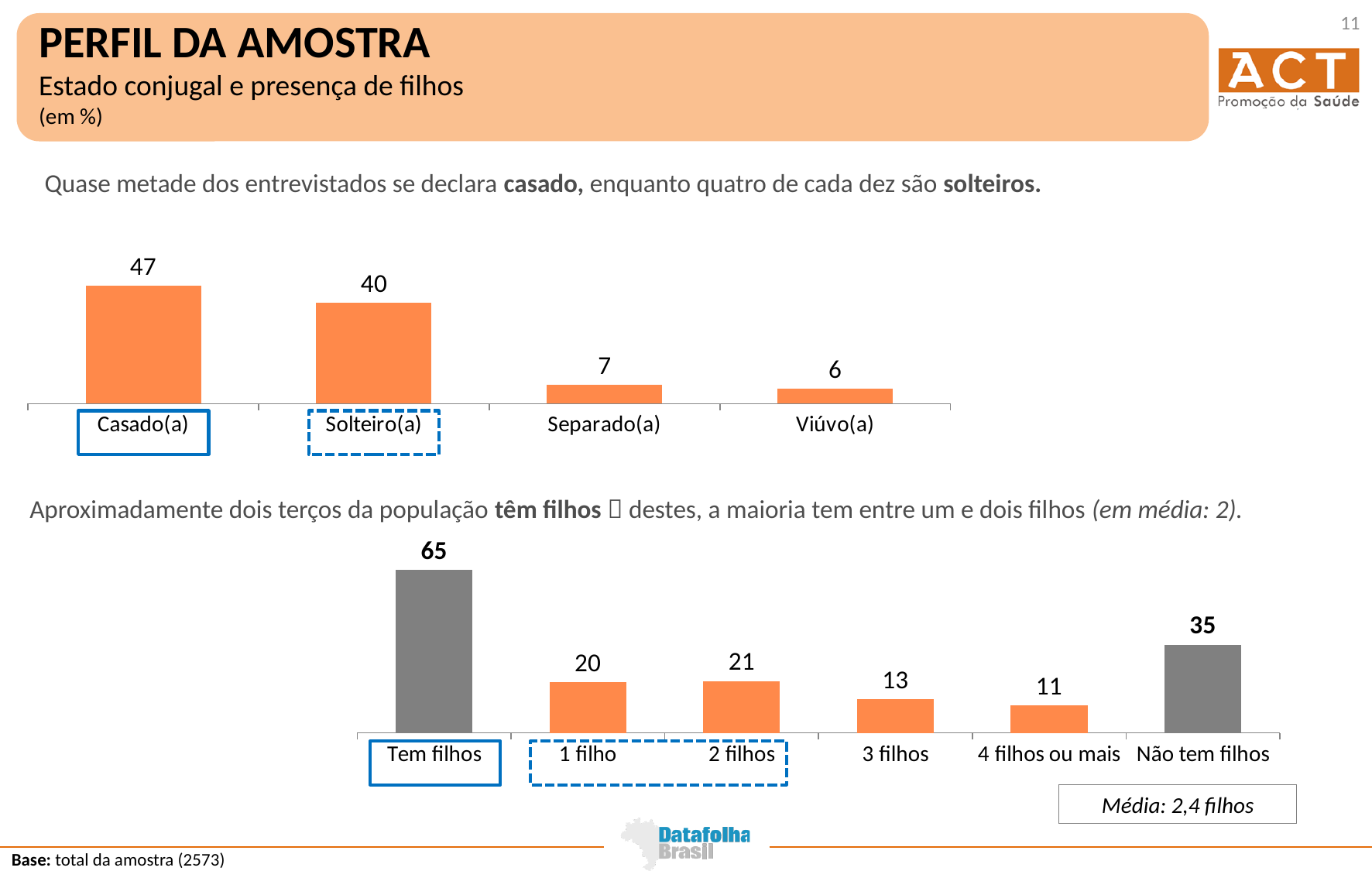
In the bottom chart on children, what is the difference between Tem filhos and Não tem filhos? 30 In the bottom chart on children, how many categories are shown? 6 In the top chart on marital status, which category has the highest value? Casado(a) In the top chart on marital status, what is the value for Viúvo(a)? 6 In the top chart on marital status, what is the difference between Casado(a) and Solteiro(a)? 7 In the top chart on marital status, what is the value for Casado(a)? 47 In the top chart on marital status, which category has the lowest value? Viúvo(a) In the bottom chart on children, what is the value for 3 filhos? 13 What type of chart is the bottom chart on children? Bar chart In the top chart on marital status, how many categories are shown? 4 In the bottom chart on children, what is the value for Tem filhos? 65 In the bottom chart on children, which is larger, 1 filho or 2 filhos? 2 filhos